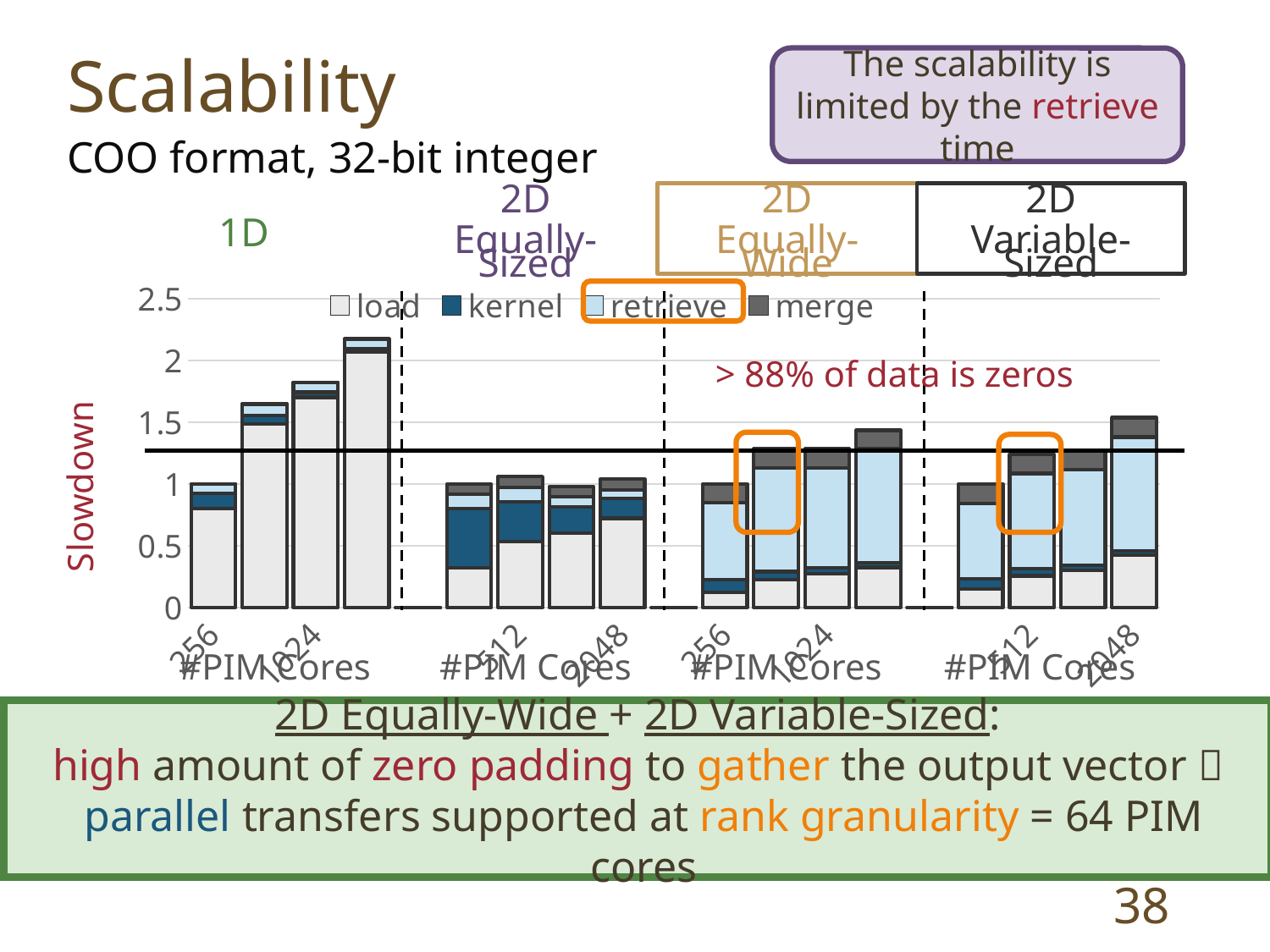
What is the title of the vertical axis of the chart? Slowdown Is the tallest bar in the 2D Equally-Wide group greater or less than 1.5? less Is the tallest bar in the 2D Equally-Sized group greater or less than 1.5? less Do the bar heights rise or fall from left to right within the 1D group? rise What are the series names listed in the chart legend? load, kernel, retrieve, merge Is the tallest bar in the 1D group greater or less than 2? greater Which is taller: the tallest bar in the 1D group or the tallest bar in the 2D Equally-Sized group? the tallest bar in the 1D group What kind of chart is shown on the slide? stacked bar chart How many bars are plotted in the chart in total? 16 Which group contains the tallest bar in the chart? 1D How many groups of bars (partitioning schemes) are shown in the chart? 4 How many series does the chart legend list? 4